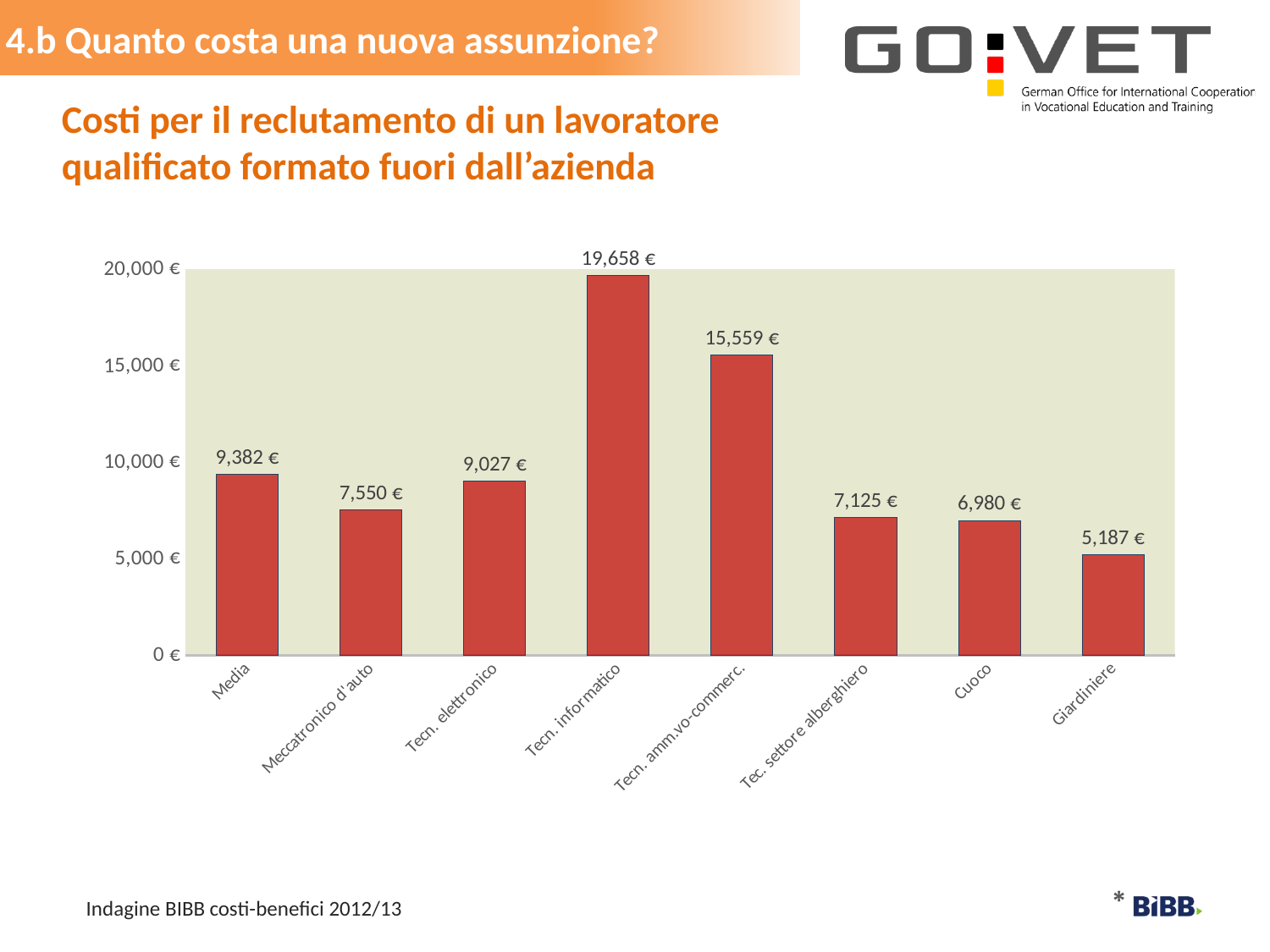
Is the value for Tecn. amm.vo-commerc. greater or less than 10,000 €? greater What is the value shown for Cuoco? 6,980 € Which category has the highest recruitment cost? Tecn. informatico What is the value shown for Media? 9,382 € What is the difference between the values for Tecn. informatico and Tecn. amm.vo-commerc.? 4,099 € Which is larger, the value for Media or the value for Tecn. elettronico? Media What is the value shown for Giardiniere? 5,187 € What is the difference between the values for Tec. settore alberghiero and Cuoco? 145 € What kind of chart is shown on the slide? Bar chart What is the recruitment cost shown for Tecn. informatico? 19,658 € How many categories are shown on the x axis of the chart? 8 Which category has the lowest recruitment cost? Giardiniere